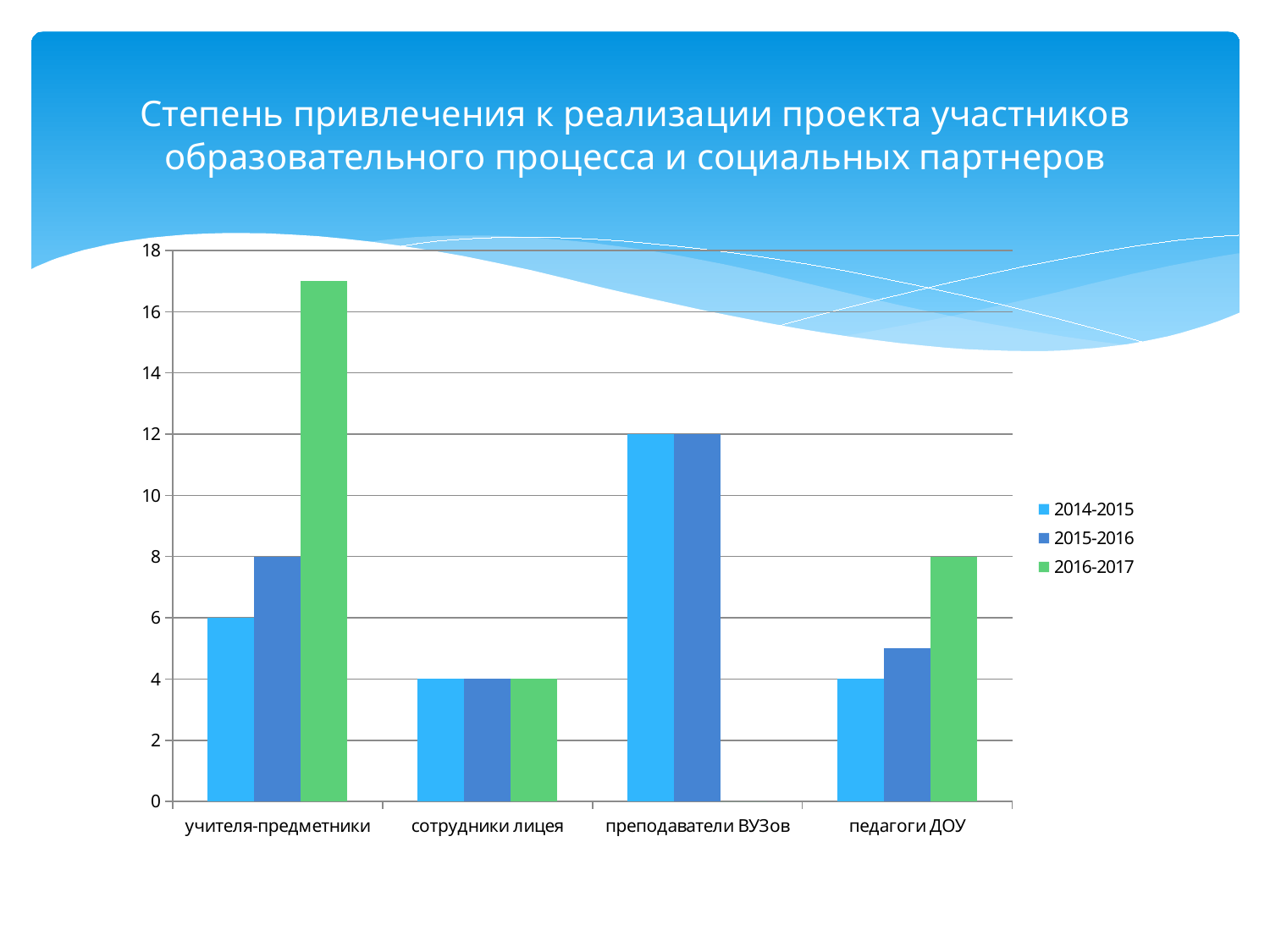
Which category has the highest value in the 2016-2017 series? учителя-предметники What is the value for учителя-предметники in the 2015-2016 series? 8 What is the value for учителя-предметники in the 2014-2015 series? 6 Is the value for учителя-предметники in the 2016-2017 series greater or less than 16? greater Is the value for педагоги ДОУ in the 2015-2016 series greater or less than 6? less How many series does the legend list? 3 What is the value for сотрудники лицея in the 2016-2017 series? 4 Which is larger for the 2014-2015 series: преподаватели ВУЗов or педагоги ДОУ? преподаватели ВУЗов How many categories are shown on the x axis? 4 What is the value for преподаватели ВУЗов in the 2014-2015 series? 12 What is the difference between the 2015-2016 and 2014-2015 values for учителя-предметники? 2 What kind of chart is shown on the slide? bar chart